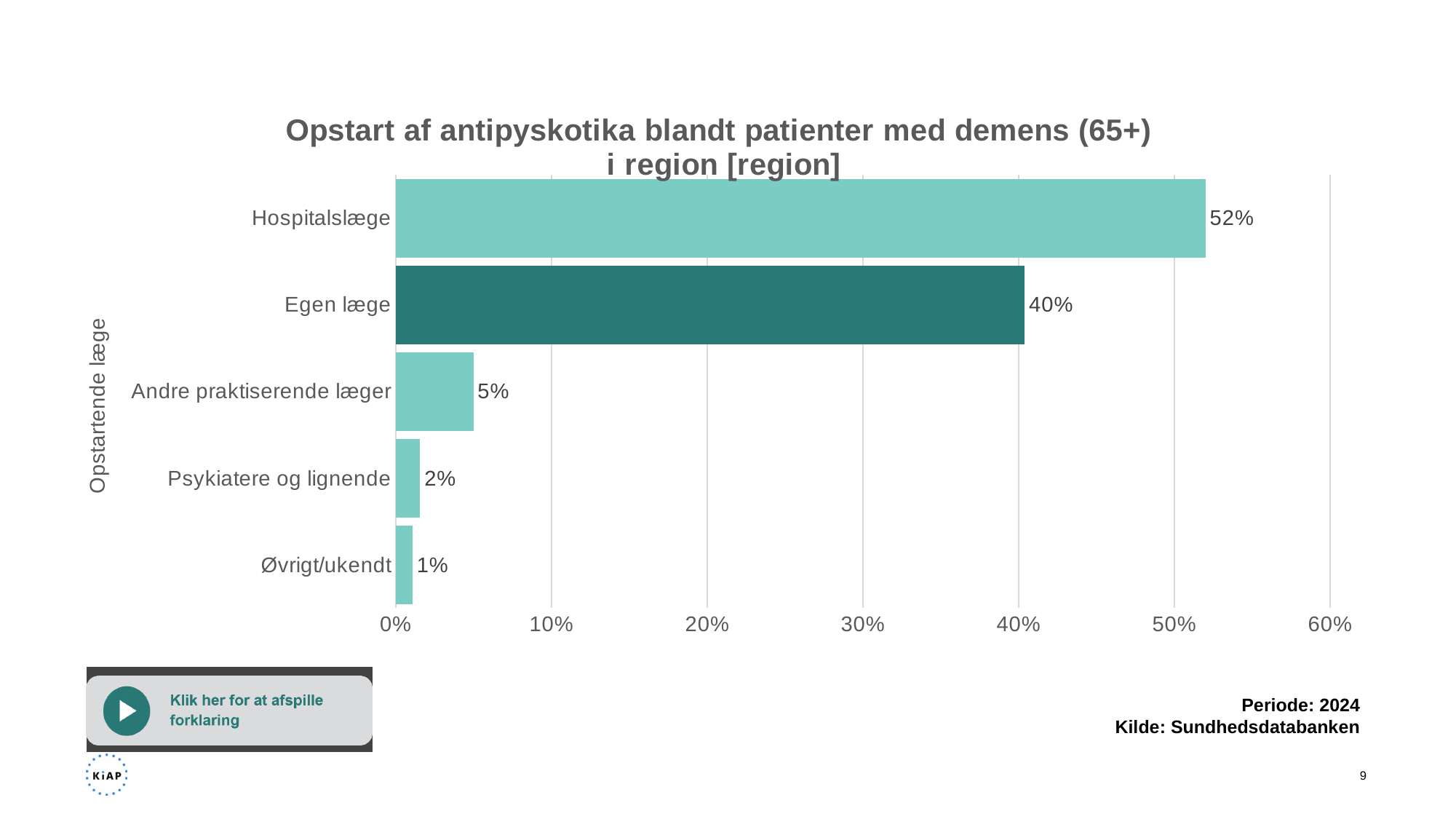
What kind of chart is shown on the slide? bar chart What is the value for Psykiatere og lignende? 2% What is the value for Hospitalslæge? 52% What is the difference between the values for Hospitalslæge and Egen læge? 12% Which category has the highest value? Hospitalslæge Which category has the lowest value? Øvrigt/ukendt Is the value for Egen læge greater or less than 30%? greater What is the value for Andre praktiserende læger? 5% What is the label of the vertical axis? Opstartende læge What is the value for Egen læge? 40% Which is larger, the value for Andre praktiserende læger or the value for Psykiatere og lignende? Andre praktiserende læger How many categories are shown on the chart? 5